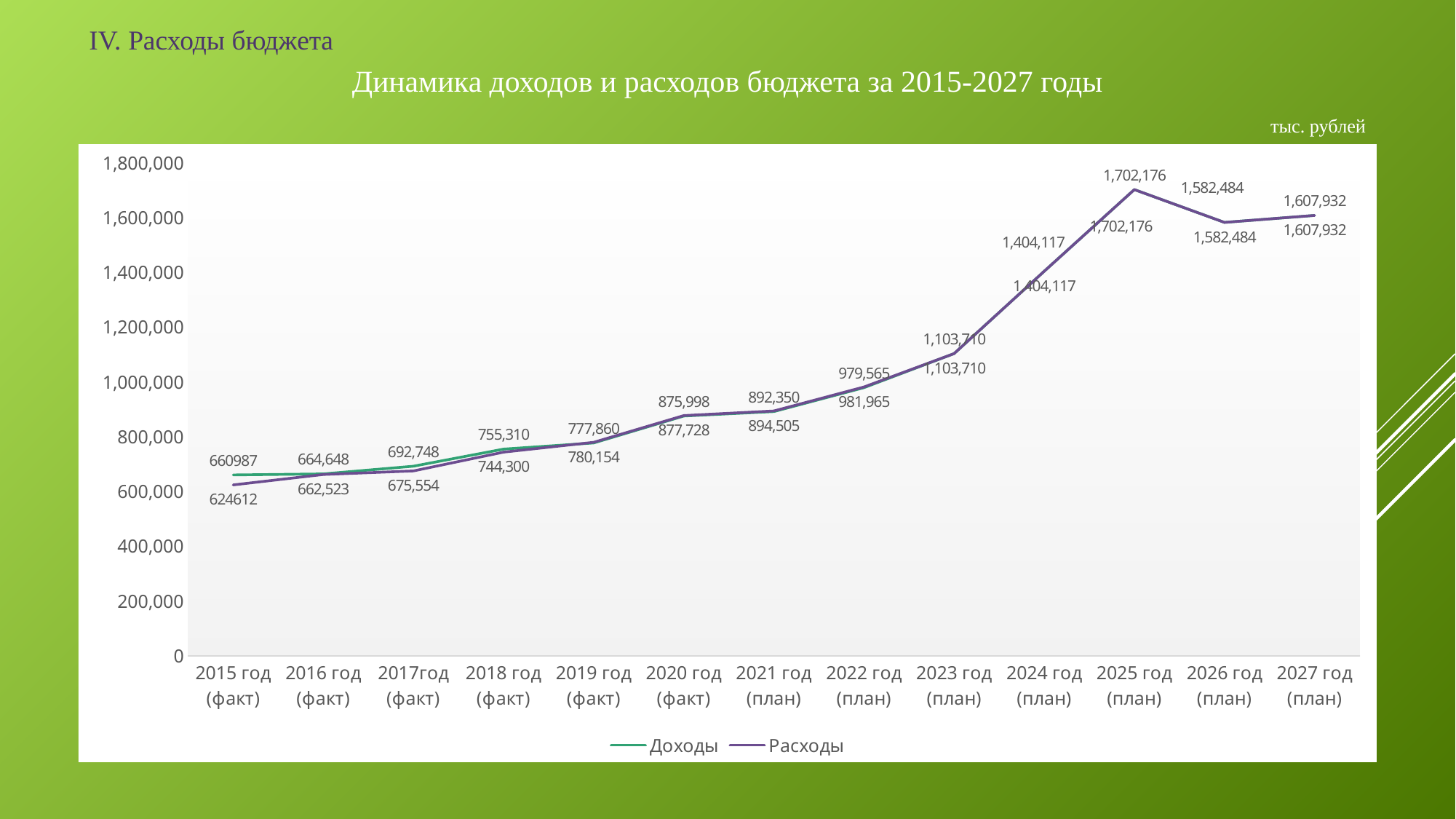
In which year is the Доходы value lowest? 2015 год (факт) How many series does the legend list? 2 What is the value of Доходы for 2016 год (факт)? 664,648 Which is larger in 2018 год (факт): Доходы or Расходы? Доходы What kind of chart is shown on the slide? Line chart What is the value of Расходы for 2015 год (факт)? 624612 What is the difference between Доходы and Расходы in 2015 год (факт)? 36375 What is the difference between the Расходы values for 2025 год (план) and 2026 год (план)? 119,692 How many years are shown on the x axis? 13 What is the value of Доходы for 2025 год (план)? 1,702,176 What is the value of Расходы for 2022 год (план)? 981,965 In which year is the Расходы value highest? 2025 год (план)